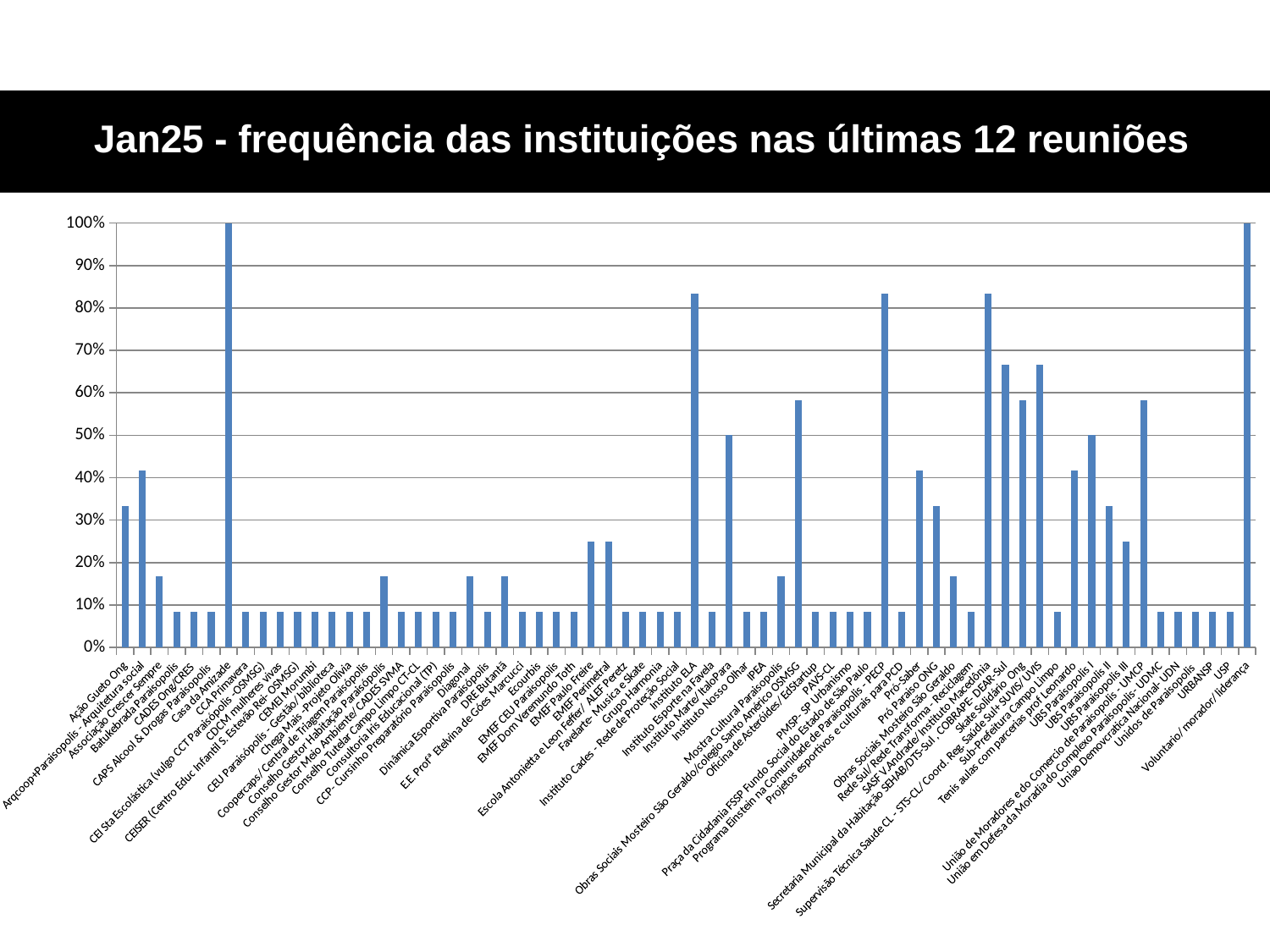
Is the value for Instituto ELA greater or less than 80%? greater Is the value for Associação Crescer Sempre greater or less than 20%? less What is the title of the chart? Jan25 - frequência das instituições nas últimas 12 reuniões Is the value for Ação Gueto Ong greater or less than 30%? greater How many bars reach 100%? 2 What is the value for Casa da Amizade? 100% What type of chart is shown on the slide? bar chart What is the value for Voluntario/ morador/ liderança? 100% Which is larger, the value for Casa da Amizade or the value for Ação Gueto Ong? Casa da Amizade What is the highest value shown on the vertical axis? 100%